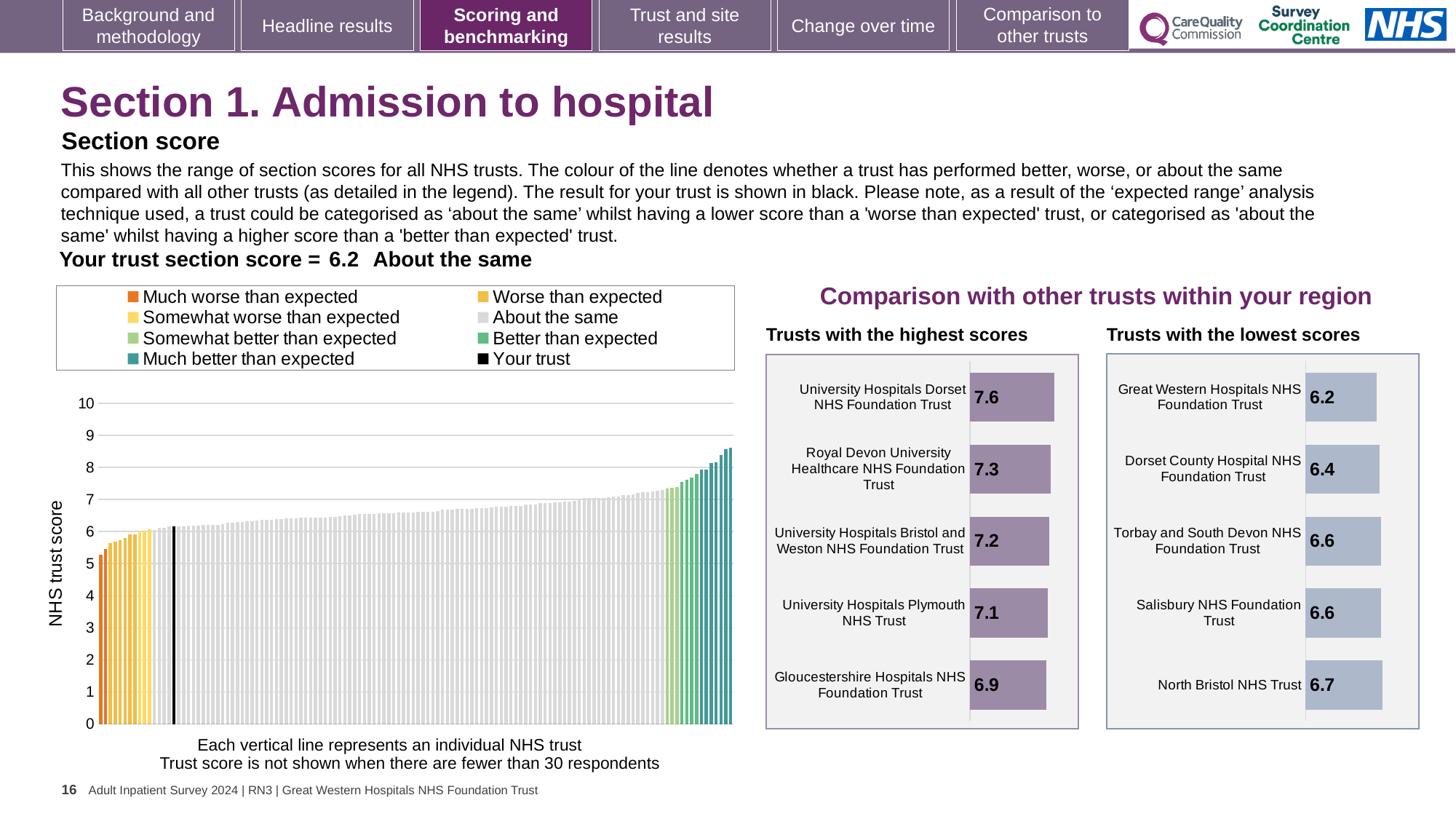
In the 'Trusts with the lowest scores' chart, what is the score for Dorset County Hospital NHS Foundation Trust? 6.4 How many entries does the legend of the main chart on the left list? 8 In the 'Trusts with the lowest scores' chart, which has the larger score: North Bristol NHS Trust or Great Western Hospitals NHS Foundation Trust? North Bristol NHS Trust In the main chart on the left showing all NHS trusts, do the trust scores rise or fall from left to right? rise In the 'Trusts with the lowest scores' chart, how many trusts are shown? 5 In the 'Trusts with the highest scores' chart, what is the difference between the scores of University Hospitals Dorset NHS Foundation Trust and University Hospitals Plymouth NHS Trust? 0.5 In the 'Trusts with the highest scores' chart, which trust has the highest score? University Hospitals Dorset NHS Foundation Trust In the 'Trusts with the lowest scores' chart, what is the difference between the scores of North Bristol NHS Trust and Great Western Hospitals NHS Foundation Trust? 0.5 In the 'Trusts with the highest scores' chart, what is the score for University Hospitals Dorset NHS Foundation Trust? 7.6 In the main chart on the left showing all NHS trusts, what is the section score for your trust (the black bar)? 6.2 In the 'Trusts with the lowest scores' chart, which trust has the lowest score? Great Western Hospitals NHS Foundation Trust In the 'Trusts with the highest scores' chart, what is the score for Gloucestershire Hospitals NHS Foundation Trust? 6.9